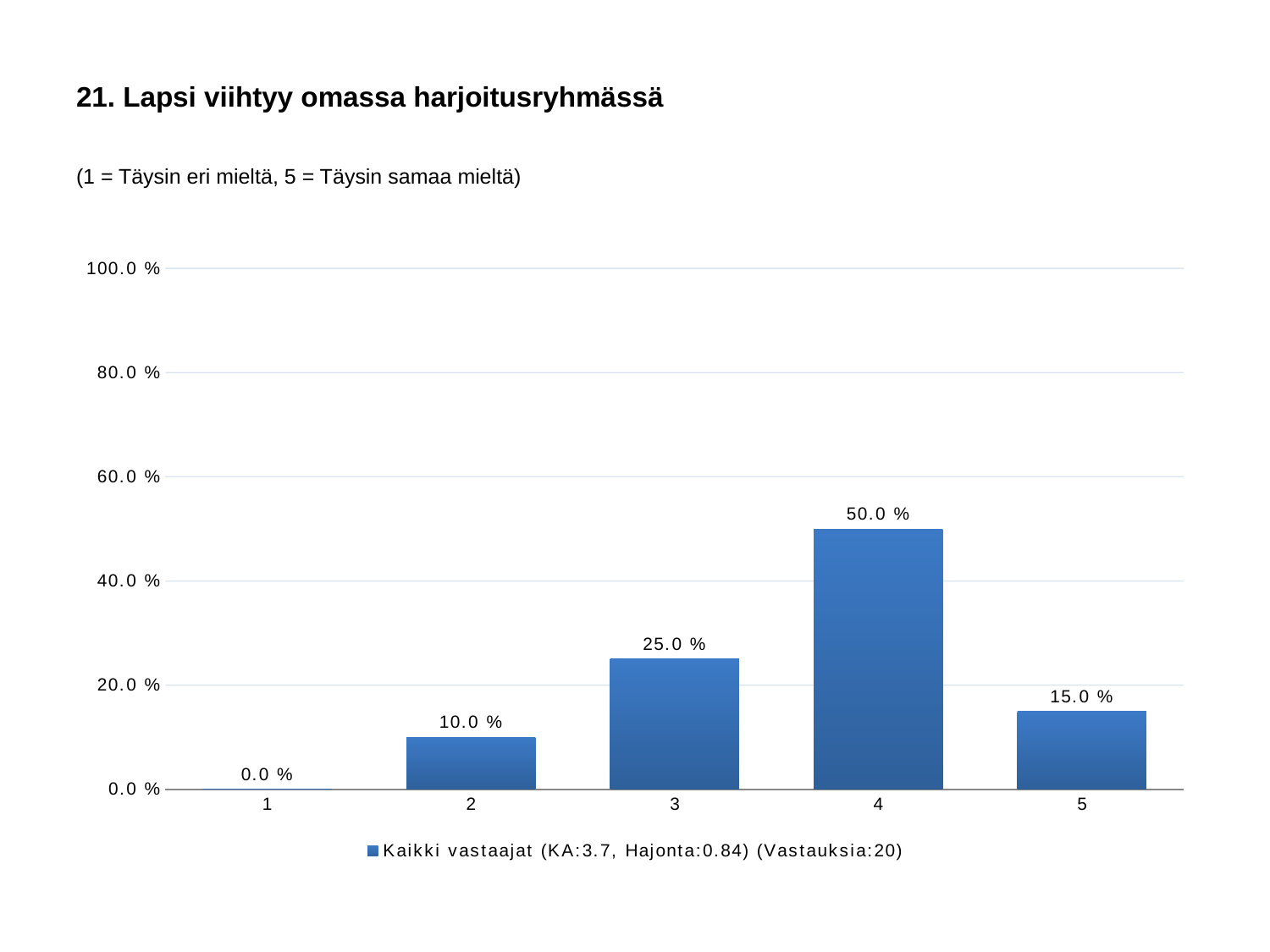
What is the difference between the values for category 4 and category 3? 25.0 % How many series does the legend list? 1 What is the value for category 4? 50.0 % Which is larger, the value for category 3 or the value for category 5? 3 What is the value for category 5? 15.0 % Is the value for category 4 greater or less than 40.0 %? greater Which category has the lowest value? 1 What is the number of responses (Vastauksia) given in the legend? 20 What is the value for category 2? 10.0 % Which category has the highest value? 4 How many categories are shown on the x axis? 5 What kind of chart is shown on the slide? bar chart